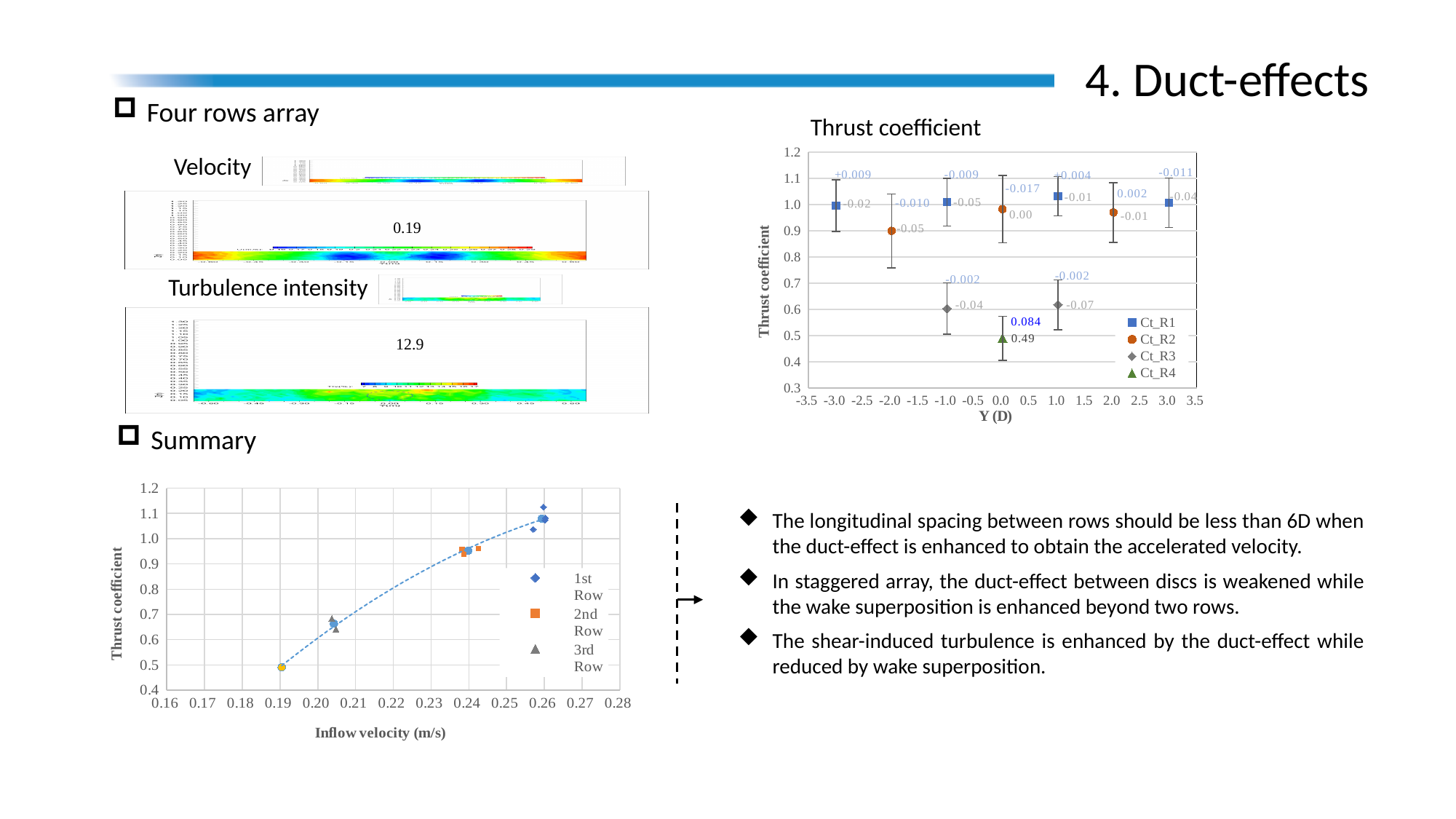
On the Thrust coefficient chart, is the Ct_R1 value at Y = 1.0 greater or less than 0.9? greater On the Summary chart at the bottom left, how many series does the legend list? 3 On the Thrust coefficient chart, how many series does the legend list? 4 On the Thrust coefficient chart, what is the title of the x axis? Y (D) On the Summary chart at the bottom left, what is the title of the x axis? Inflow velocity (m/s) On the Thrust coefficient chart, is the Ct_R3 value at Y = -1.0 greater or less than 0.7? less On the Thrust coefficient chart, is the Ct_R2 value at Y = -2.0 greater or less than 1.0? less On the Summary chart at the bottom left, does the thrust coefficient rise or fall as inflow velocity increases? rise On the Thrust coefficient chart, which series has the lowest thrust coefficient? Ct_R4 On the Thrust coefficient chart, what kind of chart is it? scatter chart On the Thrust coefficient chart, which is larger: the Ct_R1 value at Y = -3.0 or the Ct_R3 value at Y = -1.0? Ct_R1 at Y = -3.0